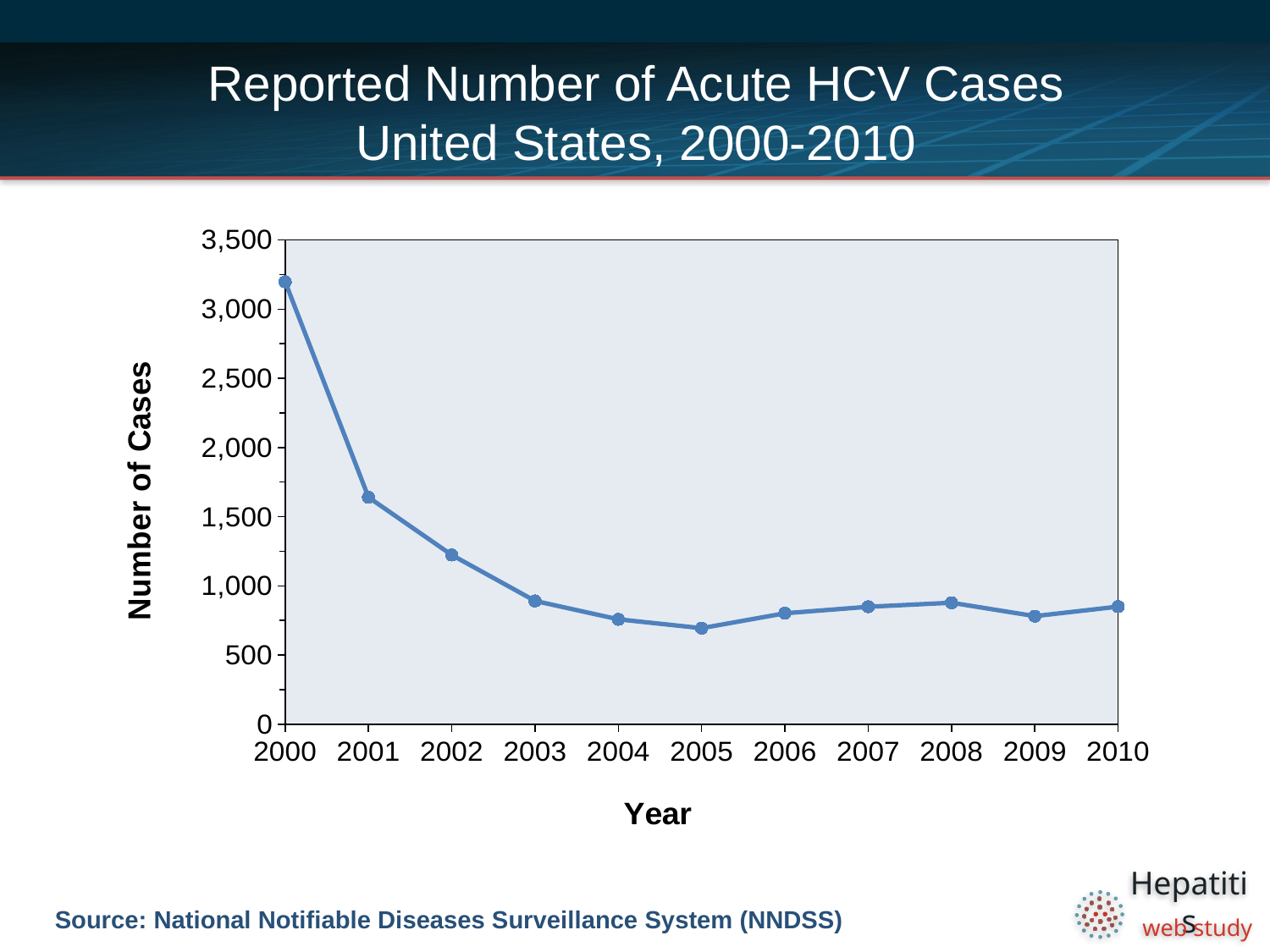
Which year has the lowest reported number of acute HCV cases? 2005 Which year has more reported cases, 2001 or 2002? 2001 What is the title of the chart on the slide? Reported Number of Acute HCV Cases United States, 2000-2010 Is the number of cases in 2005 greater or less than 500? greater Which year has the highest reported number of acute HCV cases? 2000 What is the label on the y axis of the chart? Number of Cases Overall, do the reported cases rise or fall from 2000 to 2010? fall Is the number of cases in 2001 greater or less than 1,500? greater How many years are plotted on the x axis of the chart? 11 What kind of chart is shown on the slide? line chart Is the number of cases in 2000 greater or less than 3,000? greater